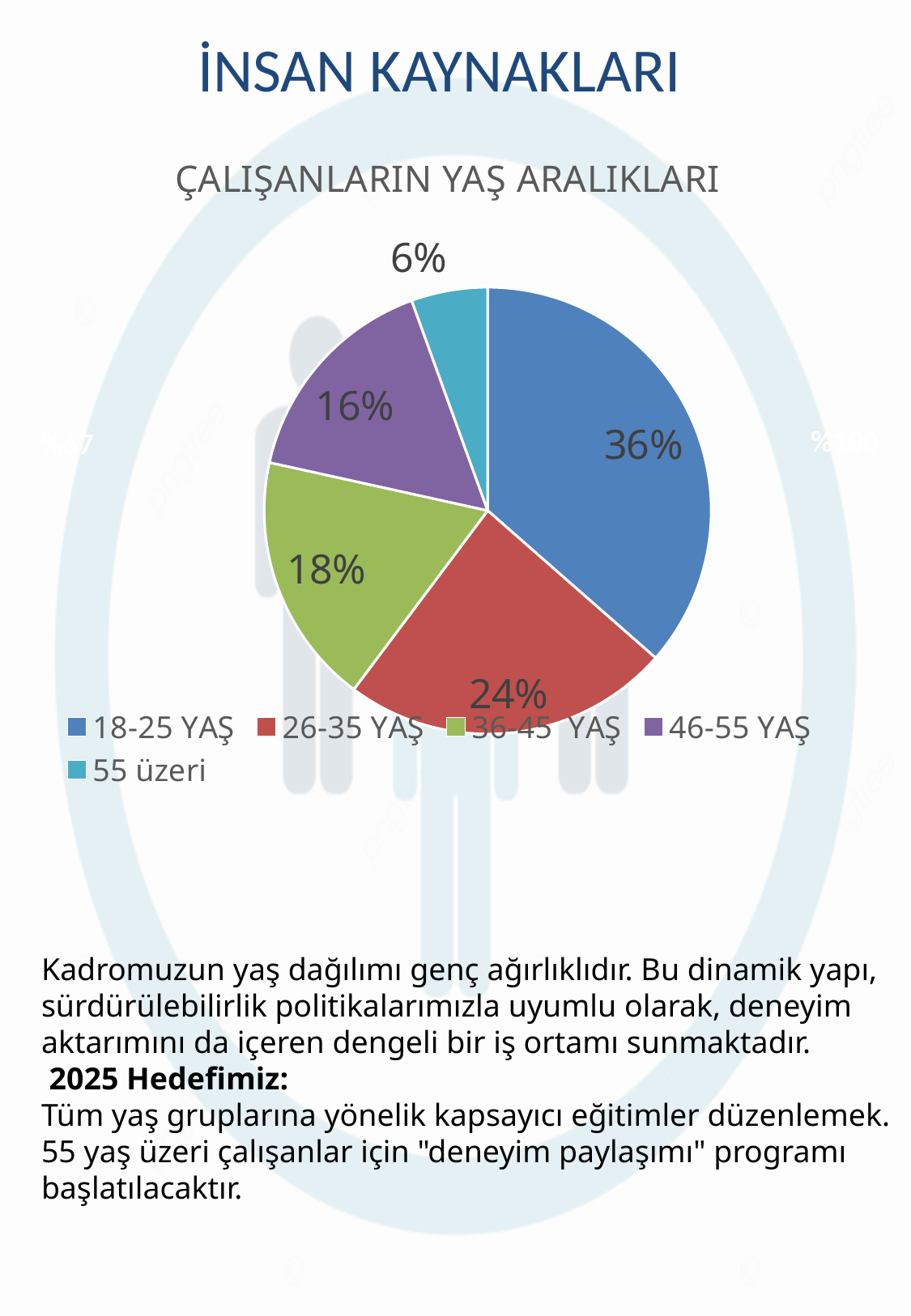
What is the difference in percentage points between the 18-25 YAŞ and 26-35 YAŞ groups? 12 What is the title of the chart? ÇALIŞANLARIN YAŞ ARALIKLARI What type of chart is used to show the employees' age ranges? Pie chart What share of employees are 55 üzeri (over 55)? 6% Which age group has the smallest share of employees? 55 üzeri Which group has a larger share: 36-45 YAŞ or 46-55 YAŞ? 36-45 YAŞ What share of employees are in the 26-35 YAŞ age group? 24% Which age group has the largest share of employees? 18-25 YAŞ What share of employees are in the 18-25 YAŞ age group? 36% What share of employees are in the 36-45 YAŞ age group? 18% What share of employees are in the 46-55 YAŞ age group? 16% How many age groups are shown in the pie chart? 5